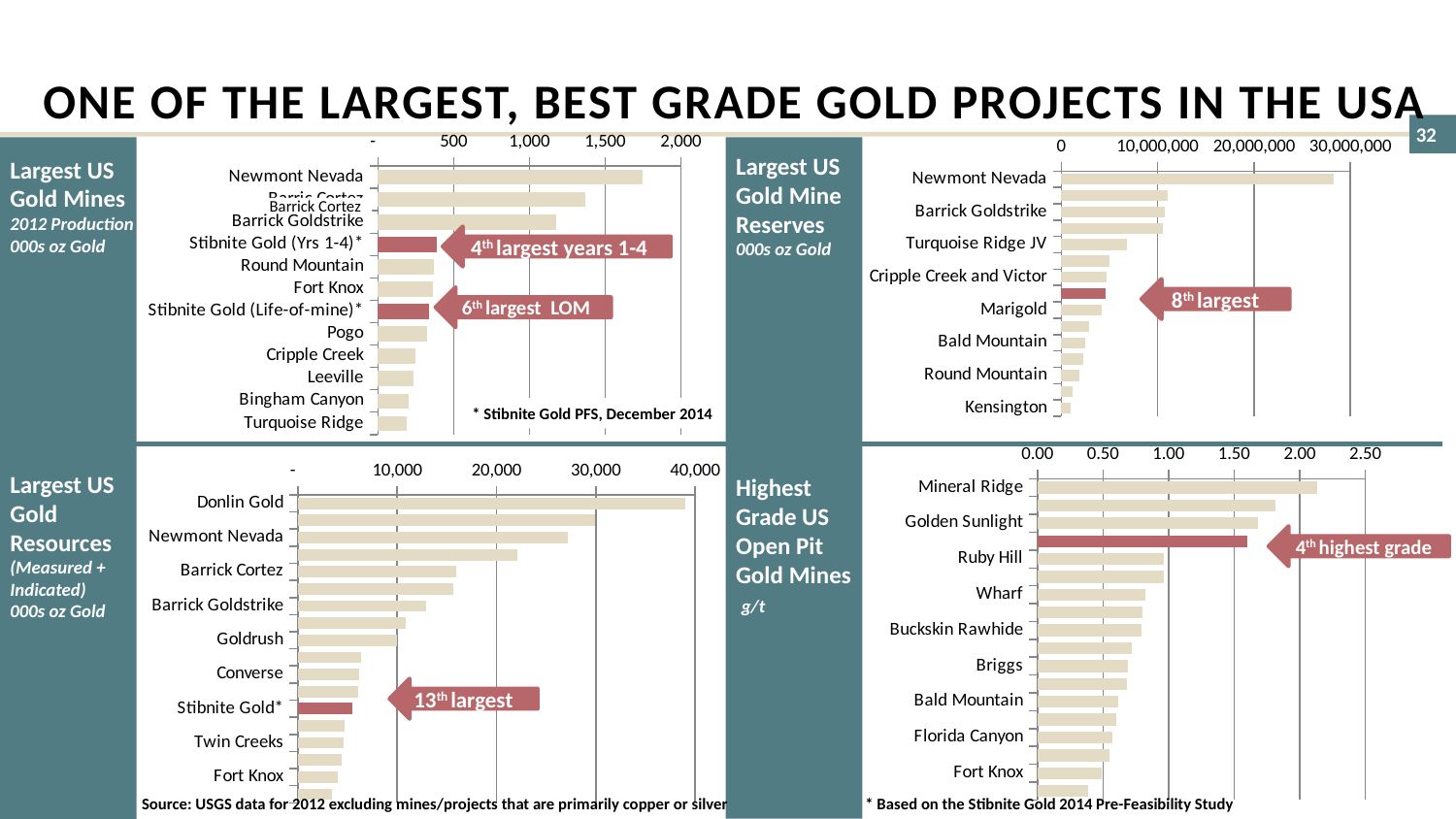
In the 'Largest US Gold Resources (Measured + Indicated)' chart, is the value for Donlin Gold greater or less than 30,000? greater In the 'Largest US Gold Mine Reserves' chart, is the value for Newmont Nevada greater or less than 20,000,000? greater In the 'Largest US Gold Mines 2012 Production' chart, is the value for Stibnite Gold (Yrs 1-4) greater or less than 500? less In the 'Largest US Gold Mine Reserves' chart, which mine has the largest reserves? Newmont Nevada What kind of chart is the 'Largest US Gold Mines 2012 Production' chart at the top left? bar chart In the 'Largest US Gold Mines 2012 Production' chart, which has the larger value, Newmont Nevada or Barrick Cortez? Newmont Nevada In the 'Largest US Gold Mines 2012 Production' chart, which mine has the highest production? Newmont Nevada How many mines are listed in the 'Largest US Gold Mines 2012 Production' chart? 12 In the 'Highest Grade US Open Pit Gold Mines' chart, which mine has the highest grade? Mineral Ridge According to the annotation on the 'Largest US Gold Resources' chart, what rank does Stibnite Gold hold? 13th largest